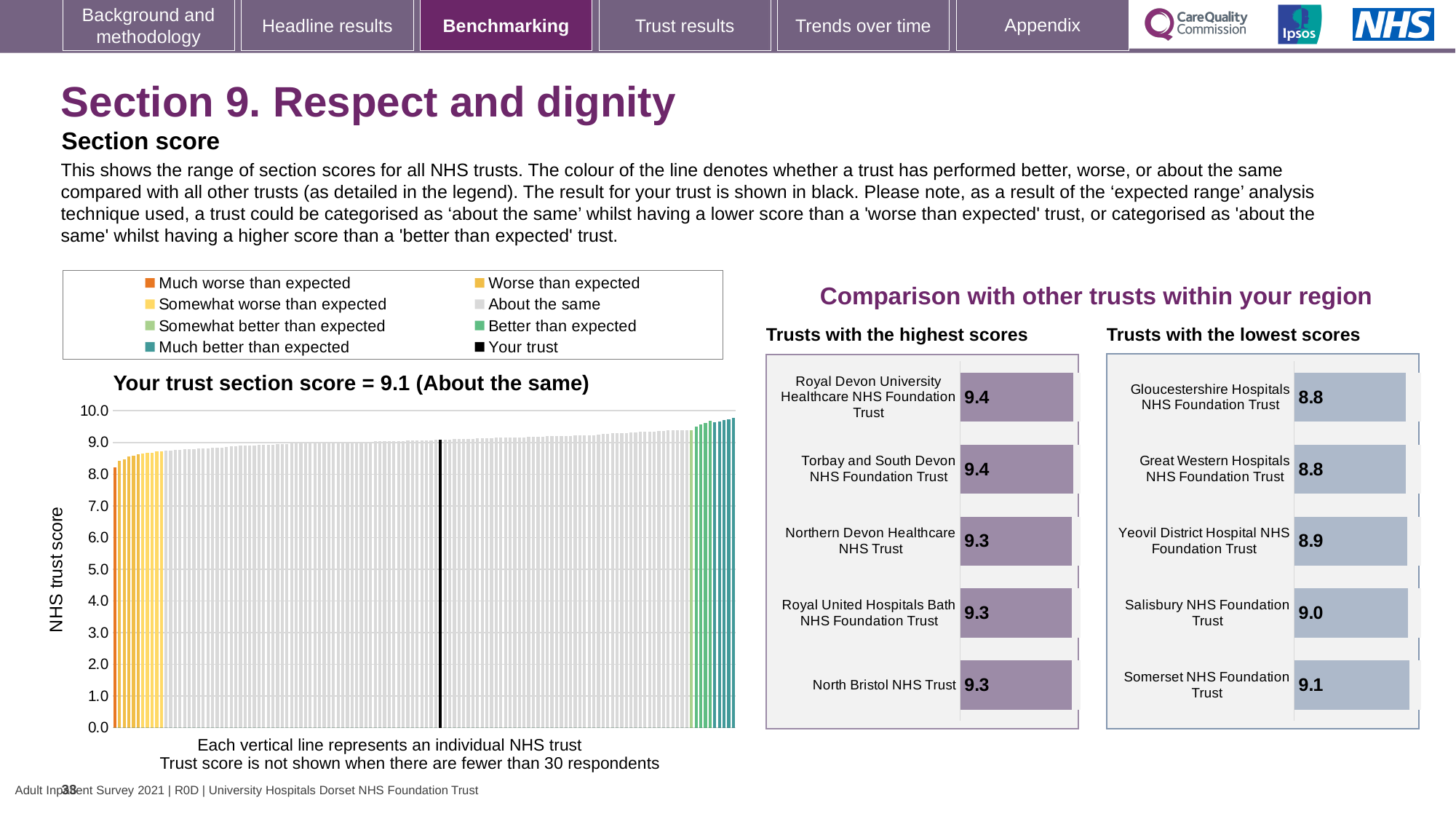
On the 'Trusts with the highest scores' chart, what is the score for Northern Devon Healthcare NHS Trust? 9.3 How many entries does the legend above the 'Your trust section score' chart list? 8 On the 'Your trust section score' chart, what is the section score for your trust? 9.1 What kind of chart is the 'Your trust section score' chart? bar chart On the 'Trusts with the highest scores' chart, what is the score for Torbay and South Devon NHS Foundation Trust? 9.4 On the 'Trusts with the lowest scores' chart, which has the larger score: Yeovil District Hospital NHS Foundation Trust or Salisbury NHS Foundation Trust? Salisbury NHS Foundation Trust On the 'Trusts with the lowest scores' chart, which trust has the highest score? Somerset NHS Foundation Trust On the 'Your trust section score' chart, do the trust scores rise or fall from left to right? rise How many trusts are shown on the 'Trusts with the highest scores' chart? 5 On the 'Your trust section score' chart, is the value of the leftmost bar greater or less than 9.0? less On the 'Trusts with the lowest scores' chart, what is the difference between the scores of Somerset NHS Foundation Trust and Gloucestershire Hospitals NHS Foundation Trust? 0.3 On the 'Your trust section score' chart, which category does your trust fall into? About the same